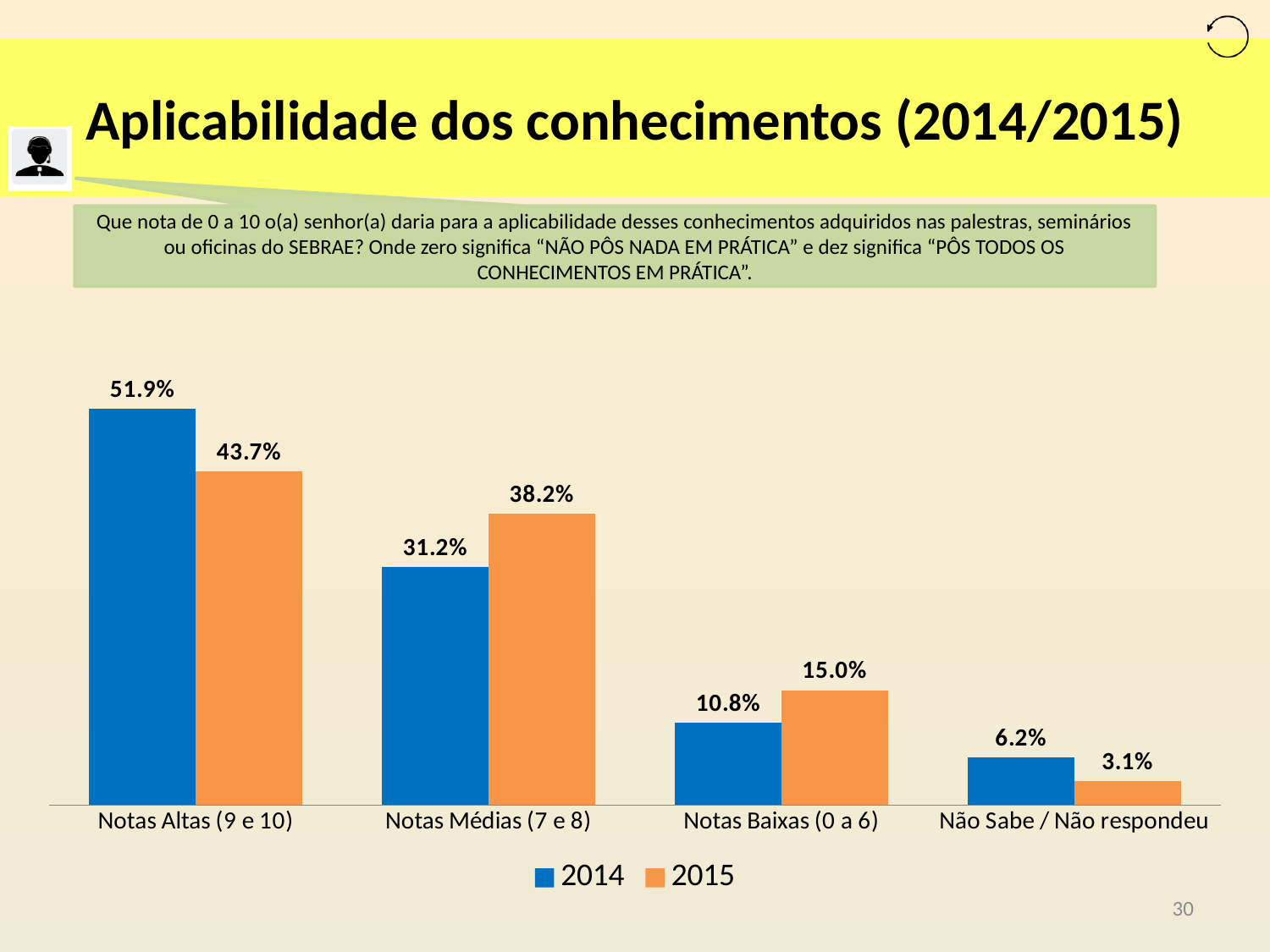
How many categories are shown on the x axis? 4 What is the value for Notas Médias (7 e 8) in 2015? 38.2% How many series does the legend list? 2 Which category has the lowest value for 2014? Não Sabe / Não respondeu What is the value for Não Sabe / Não respondeu in 2015? 3.1% Which colour represents the 2015 series in the legend? Orange What kind of chart is shown on the slide? Bar chart What is the difference between the 2014 and 2015 values for Notas Altas (9 e 10)? 8.2% Which category has the highest value for 2015? Notas Altas (9 e 10) Which is larger for Notas Médias (7 e 8): the 2014 value or the 2015 value? 2015 What is the value for Notas Altas (9 e 10) in 2014? 51.9% What is the difference between the 2015 and 2014 values for Notas Baixas (0 a 6)? 4.2%